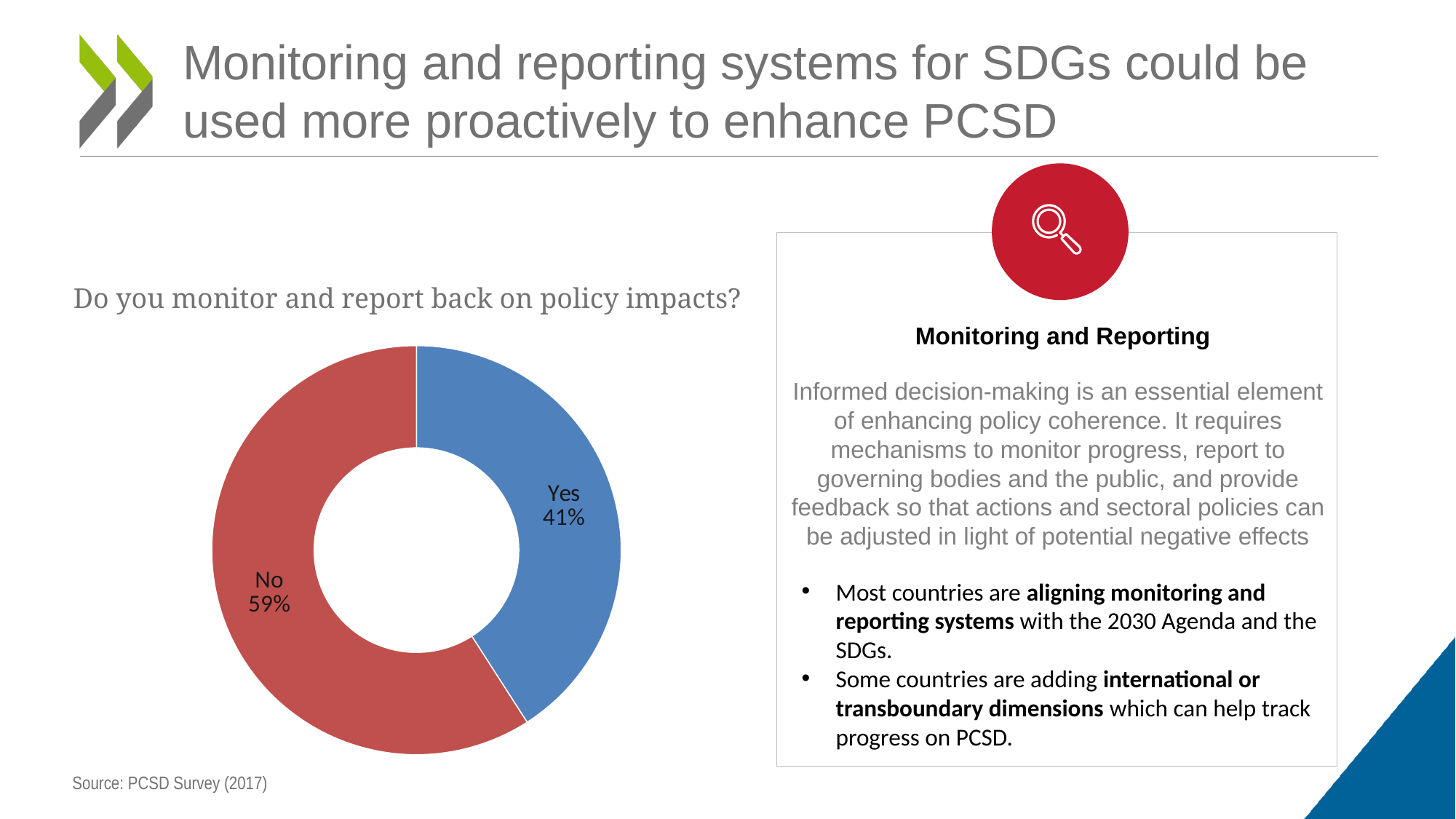
What question does the chart answer? Do you monitor and report back on policy impacts? What is the difference in percentage points between the No and Yes shares? 18 What share of the chart does the No slice represent? 59% Which response has the smaller share of the chart? Yes Is the share for No greater or less than 50%? greater What colour is the Yes slice of the chart? Blue Is the share for Yes larger or smaller than the share for No? smaller What kind of chart is used to show the survey responses? Doughnut (pie) chart What percentage of respondents answered "No" to monitoring and reporting back on policy impacts? 59% How many categories are shown in the chart? 2 What percentage of respondents answered "Yes" to monitoring and reporting back on policy impacts? 41% Which response has the larger share of the chart, Yes or No? No